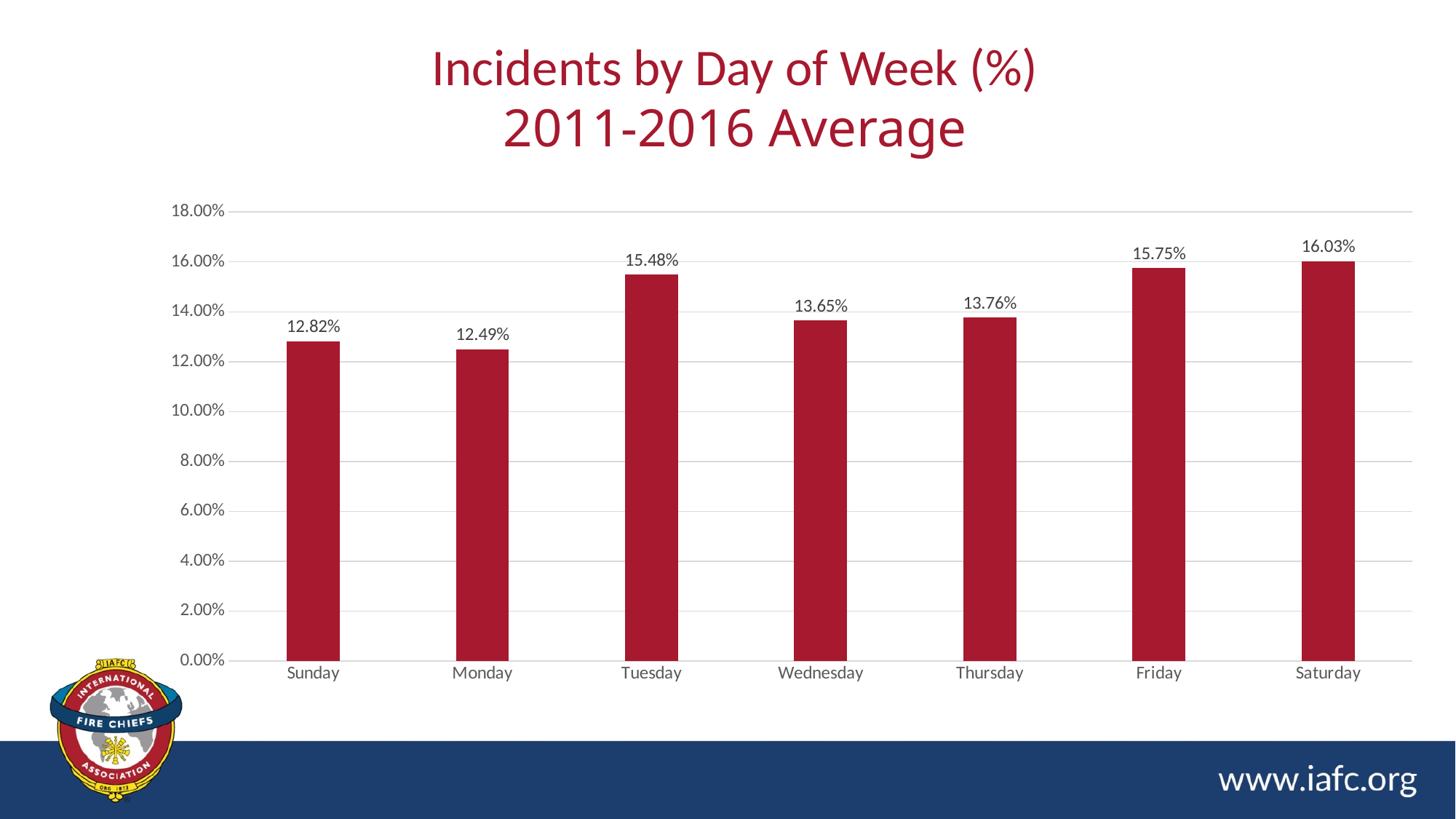
How many days are shown on the x axis? 7 Which day has the highest percentage of incidents? Saturday Which day has the lowest percentage of incidents? Monday Is the value for Thursday greater or less than 14.00%? less What is the value for Tuesday? 15.48% What is the difference between the values for Friday and Tuesday? 0.27% What is the value for Saturday? 16.03% What kind of chart is shown on the slide? bar chart What is the value for Monday? 12.49% What is the difference between the values for Saturday and Monday? 3.54% Which is larger, the value for Tuesday or the value for Wednesday? Tuesday What is the title of the chart? Incidents by Day of Week (%) 2011-2016 Average